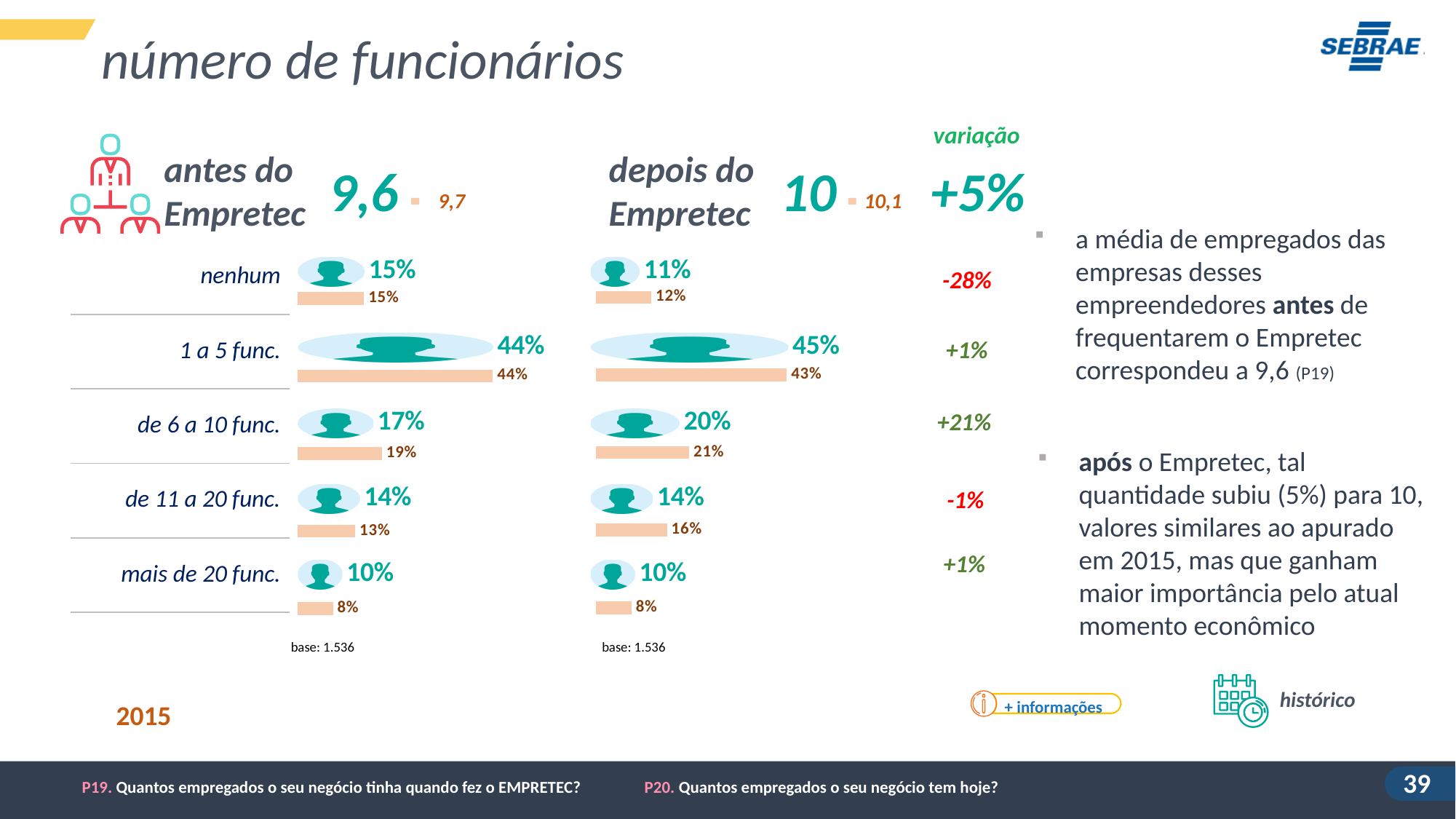
In the "antes do Empretec" chart, which category has the highest teal percentage? 1 a 5 func. In the "antes do Empretec" chart, which is larger: the teal percentage for "nenhum" or for "de 11 a 20 func."? nenhum What is the base (sample size) shown under each chart? 1.536 In the "antes do Empretec" chart, what is the orange 2015 bar value for "de 6 a 10 func."? 19% In the "depois do Empretec" chart, what is the teal percentage for "nenhum"? 11% What is the difference between the teal percentages for "de 6 a 10 func." in the "depois do Empretec" chart and the "antes do Empretec" chart? 3% In the "depois do Empretec" chart, what is the orange 2015 bar value for "de 11 a 20 func."? 16% What is the "variação" value shown for "de 6 a 10 func."? +21% What is the average number of employees shown for "depois do Empretec"? 10 How many employee-count categories are shown in each chart? 5 In the "depois do Empretec" chart, which category has the lowest teal percentage? mais de 20 func. In the "antes do Empretec" chart, what is the teal percentage for "1 a 5 func."? 44%